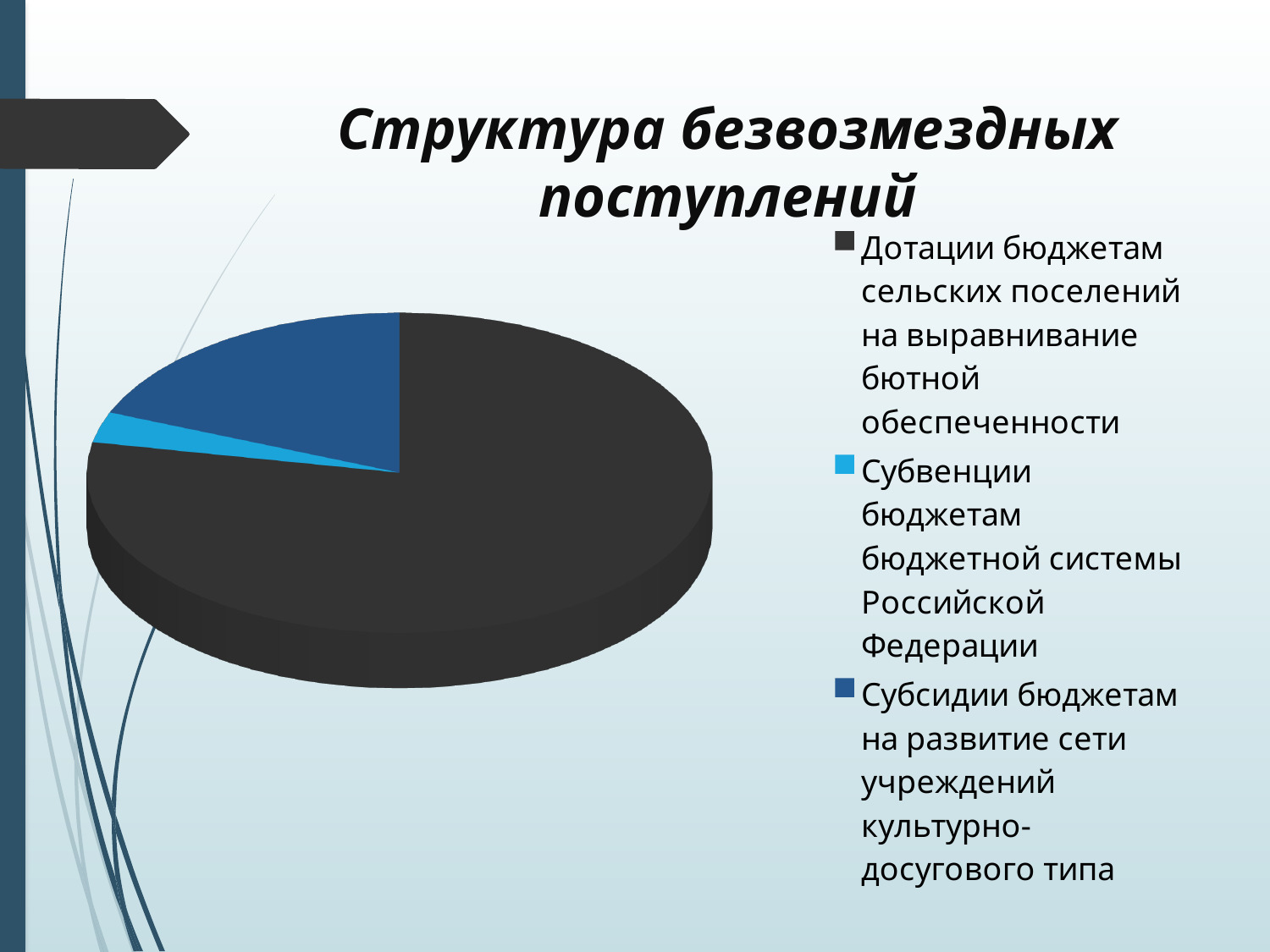
Which legend entry is shown in light blue in the pie chart? Субвенции бюджетам бюджетной системы Российской Федерации Which category has the smallest slice of the pie chart? Субвенции бюджетам бюджетной системы Российской Федерации Which slice is larger: Дотации бюджетам сельских поселений на выравнивание бютной обеспеченности or Субсидии бюджетам на развитие сети учреждений культурно-досугового типа? Дотации бюджетам сельских поселений на выравнивание бютной обеспеченности Does the largest slice of the pie chart take up more or less than half of the pie? more Which category has the largest slice of the pie chart? Дотации бюджетам сельских поселений на выравнивание бютной обеспеченности Which slice is larger: Субсидии бюджетам на развитие сети учреждений культурно-досугового типа or Субвенции бюджетам бюджетной системы Российской Федерации? Субсидии бюджетам на развитие сети учреждений культурно-досугового типа What kind of chart is shown on the slide? Pie chart How many entries does the legend of the pie chart list? 3 What is the title of the chart on the slide? Структура безвозмездных поступлений How many slices does the pie chart have? 3